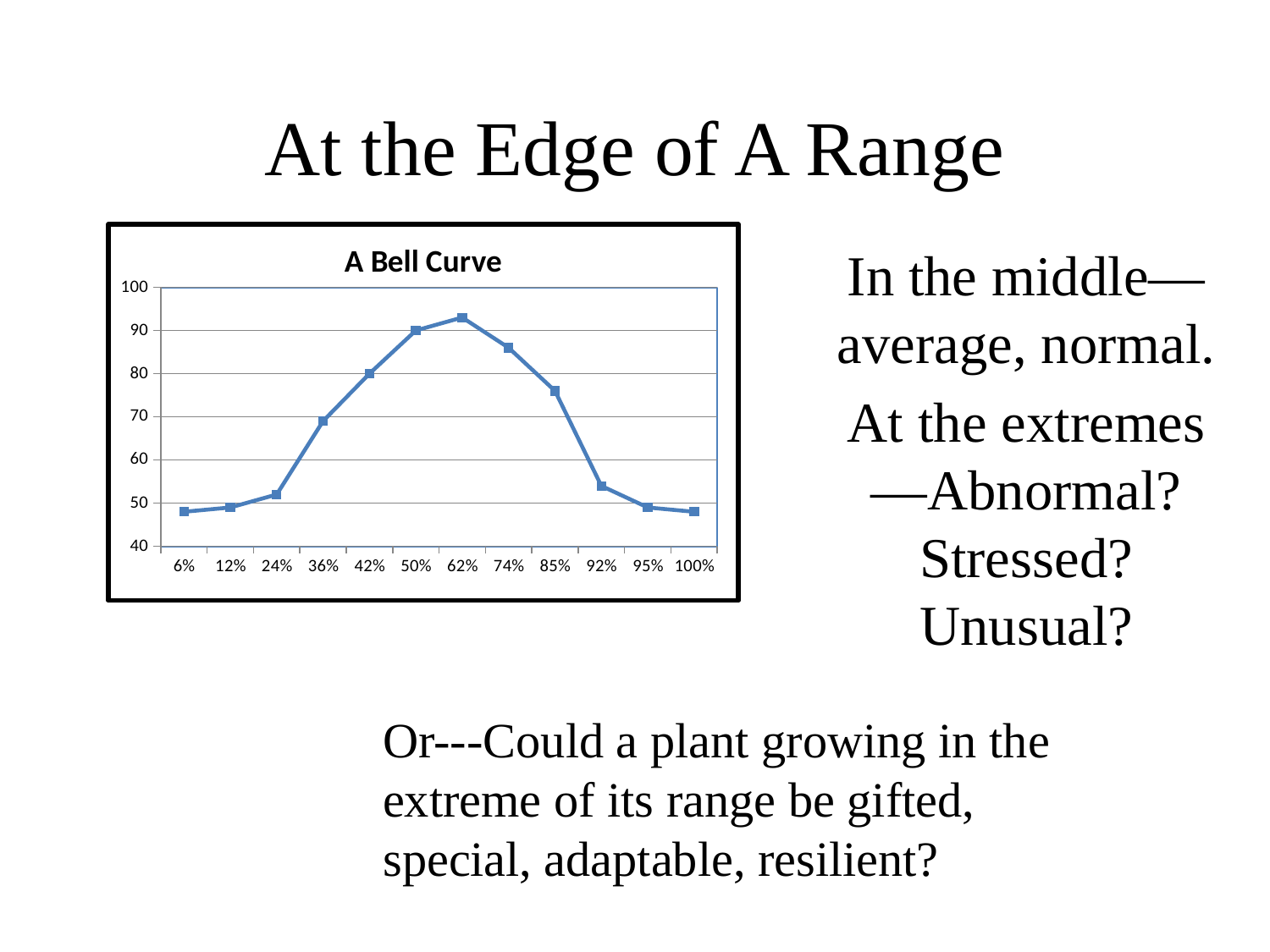
Is the value at 36% greater or less than 60? greater Is the value at 85% greater or less than 70? greater What kind of chart is shown on the slide? line chart What is the title of the chart? A Bell Curve Is the value at 74% greater or less than 80? greater Which has the larger value, 36% or 92%? 36% How many data points are plotted on the line? 12 Which has the larger value, 24% or 85%? 85% At which x-axis category does the line reach its highest value? 62% How do the values change along the x axis from 6% to 100%? They rise to a peak at 62% and then fall